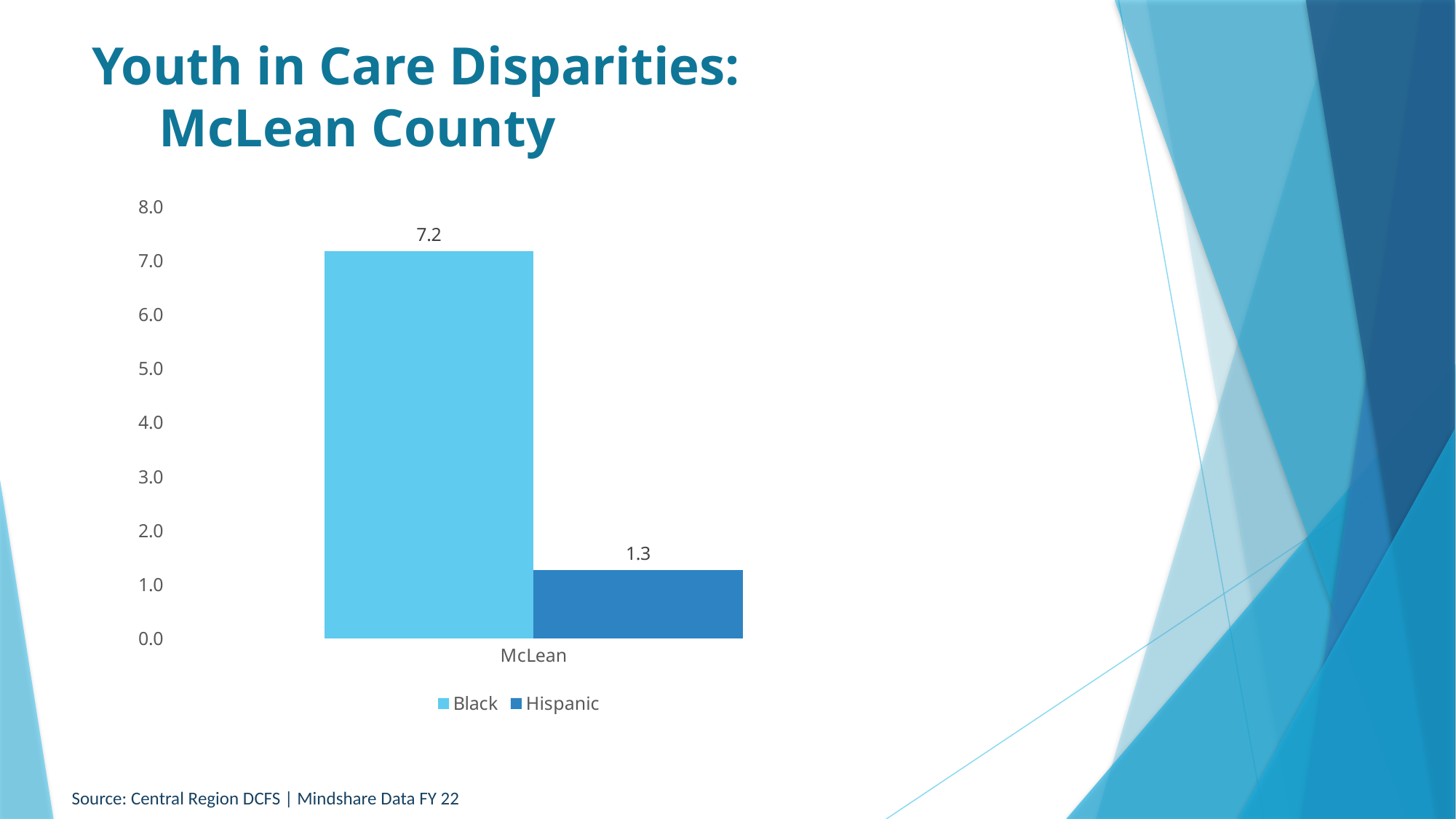
Which series has the highest value in the chart? Black How many categories are shown on the x axis? 1 Which series has the lowest value in the chart? Hispanic Which series has the higher value for McLean, Black or Hispanic? Black What is the highest value shown on the y axis? 8.0 Is the value for Hispanic in McLean greater or less than 2.0? less How many series does the legend list? 2 What is the difference between the Black and Hispanic values for McLean? 5.9 What is the value for Hispanic in McLean? 1.3 What kind of chart is shown on the slide? Bar chart Is the value for Black in McLean greater or less than 6.0? greater What is the value for Black in McLean? 7.2